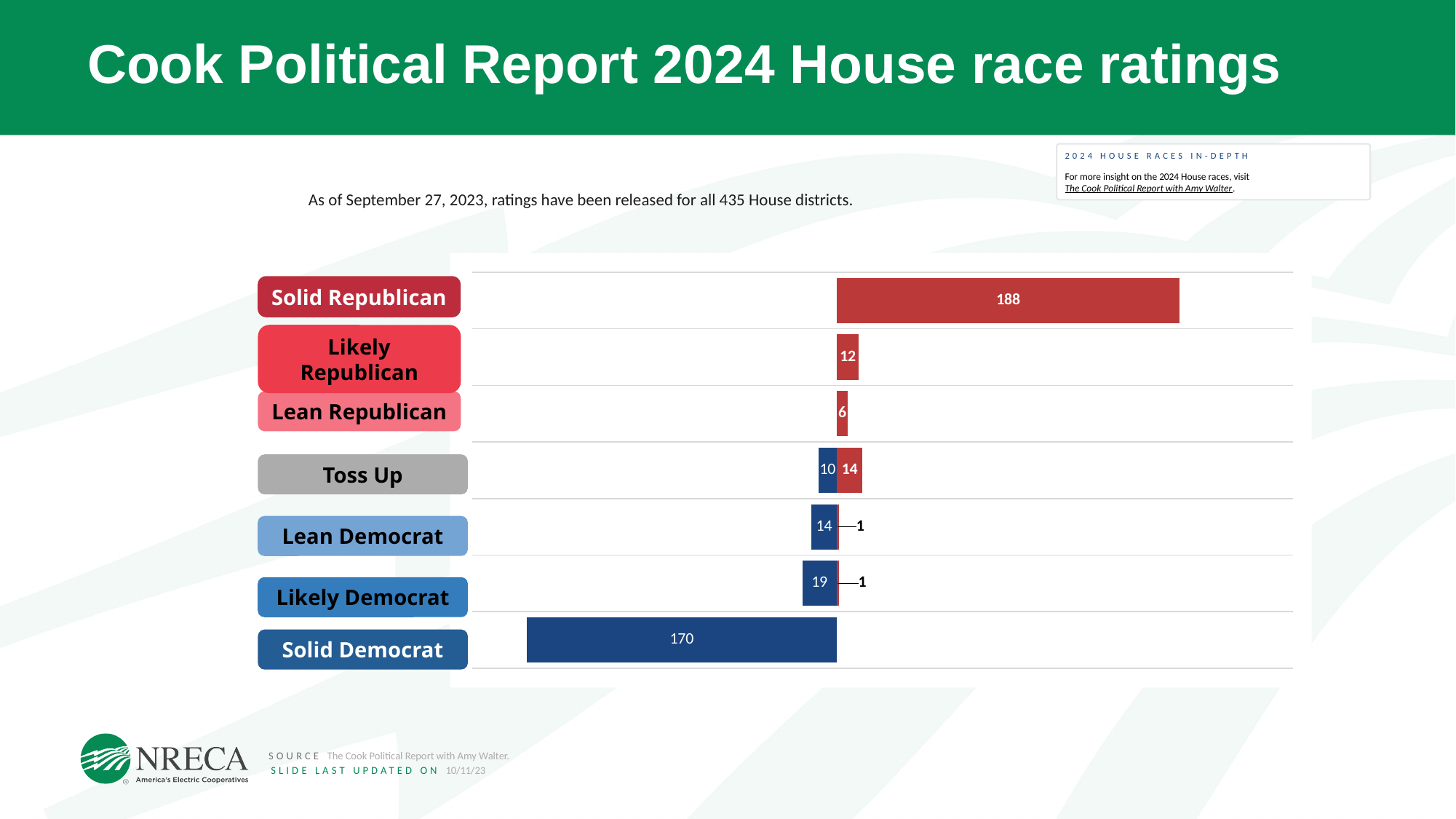
What kind of chart is shown on the slide? bar chart What is the value for Likely Republican? 12 What is the title of the slide? Cook Political Report 2024 House race ratings What is the value of the blue bar in the Likely Democrat category? 19 What is the difference between the Solid Republican and Solid Democrat values? 18 What is the total of the two bars in the Toss Up category? 24 How many rating categories are shown in the chart? 7 Which category has the largest bar? Solid Republican What is the value for Solid Democrat? 170 What is the value of the red bar in the Toss Up category? 14 What is the value for Solid Republican? 188 Which is larger, Solid Republican or Solid Democrat? Solid Republican